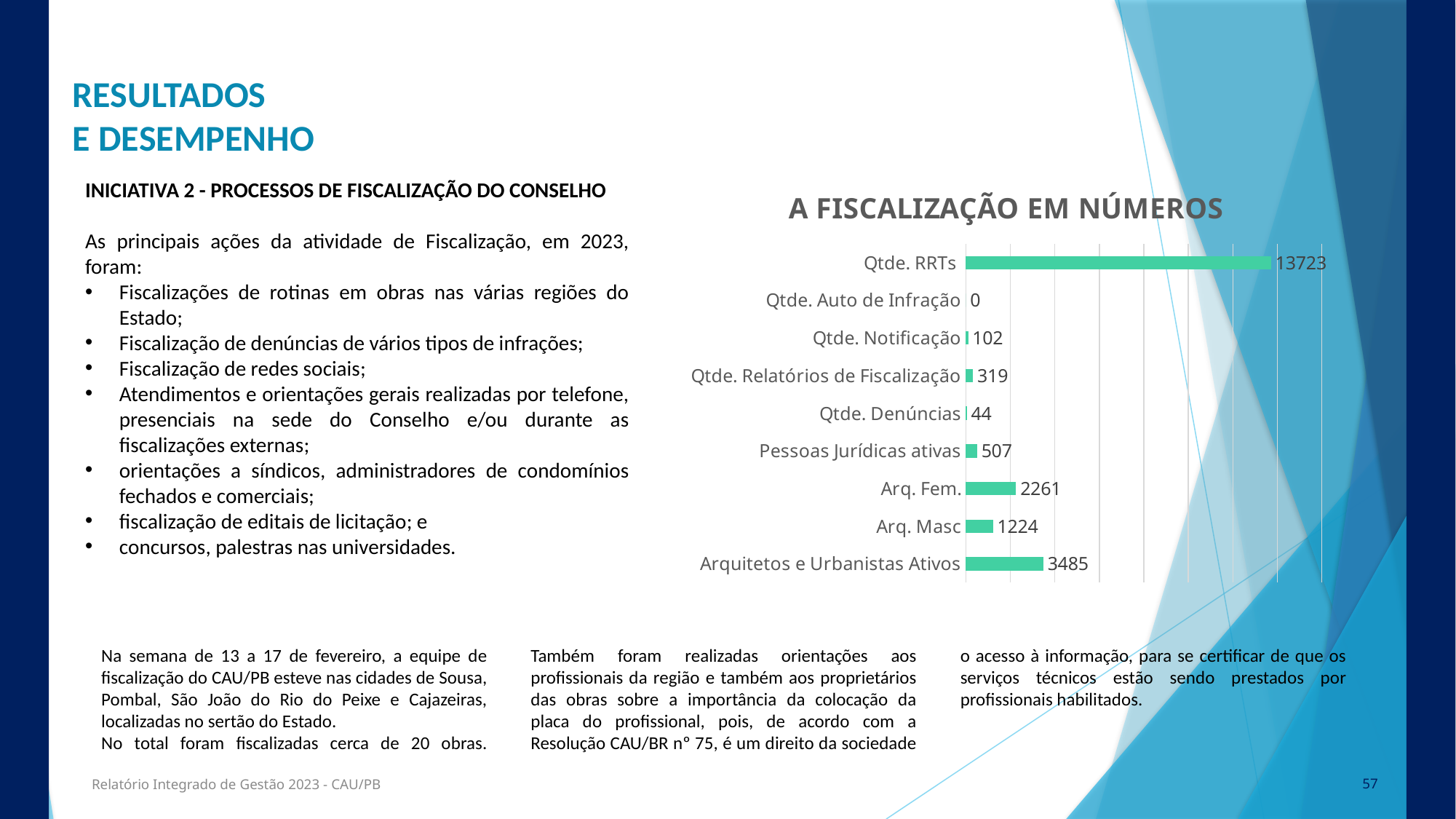
Which category has the highest value? Qtde. RRTs What is the value for Qtde. Notificação? 102 How many categories are shown in the chart? 9 What is the value for Qtde. RRTs? 13723 What is the value for Pessoas Jurídicas ativas? 507 What is the value for Arquitetos e Urbanistas Ativos? 3485 Which is larger, Qtde. Relatórios de Fiscalização or Qtde. Denúncias? Qtde. Relatórios de Fiscalização What is the title of the chart? A FISCALIZAÇÃO EM NÚMEROS What is the difference between Arq. Fem. and Arq. Masc? 1037 What is the value for Qtde. Denúncias? 44 Which category has the lowest value? Qtde. Auto de Infração What kind of chart is shown on the slide? Bar chart